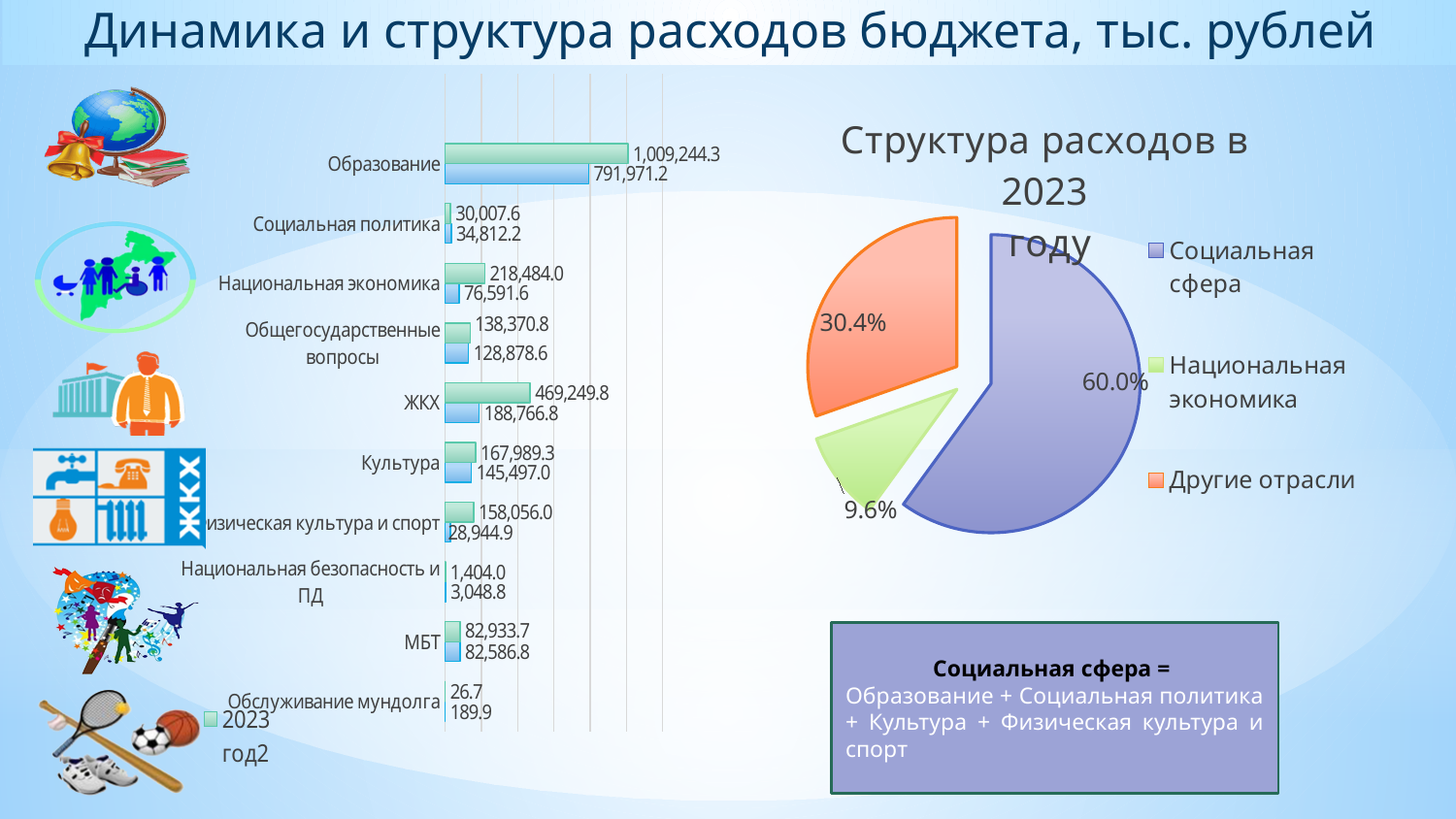
What type of chart is the chart on the left of the slide? bar chart In the pie chart 'Структура расходов в 2023 году', what share does Социальная сфера have? 60.0% How many categories are shown in the bar chart on the left? 10 In the bar chart on the left, what is the difference between the green and blue bar values for МБТ? 346.9 In the bar chart on the left, what is the 2023 (green bar) value for Национальная экономика? 218,484.0 In the bar chart on the left, what is the value shown on the blue bar for ЖКХ? 188,766.8 How many slices does the pie chart 'Структура расходов в 2023 году' have? 3 In the pie chart 'Структура расходов в 2023 году', which slice is the smallest? Национальная экономика In the bar chart on the left, which category has the highest 2023 (green bar) value? Образование In the bar chart on the left, what is the 2023 (green bar) value for Образование? 1,009,244.3 In the bar chart on the left, which category has the lowest 2023 (green bar) value? Обслуживание мундолга In the bar chart on the left, which is larger for Социальная политика: the green bar value or the blue bar value? the blue bar value (34,812.2)